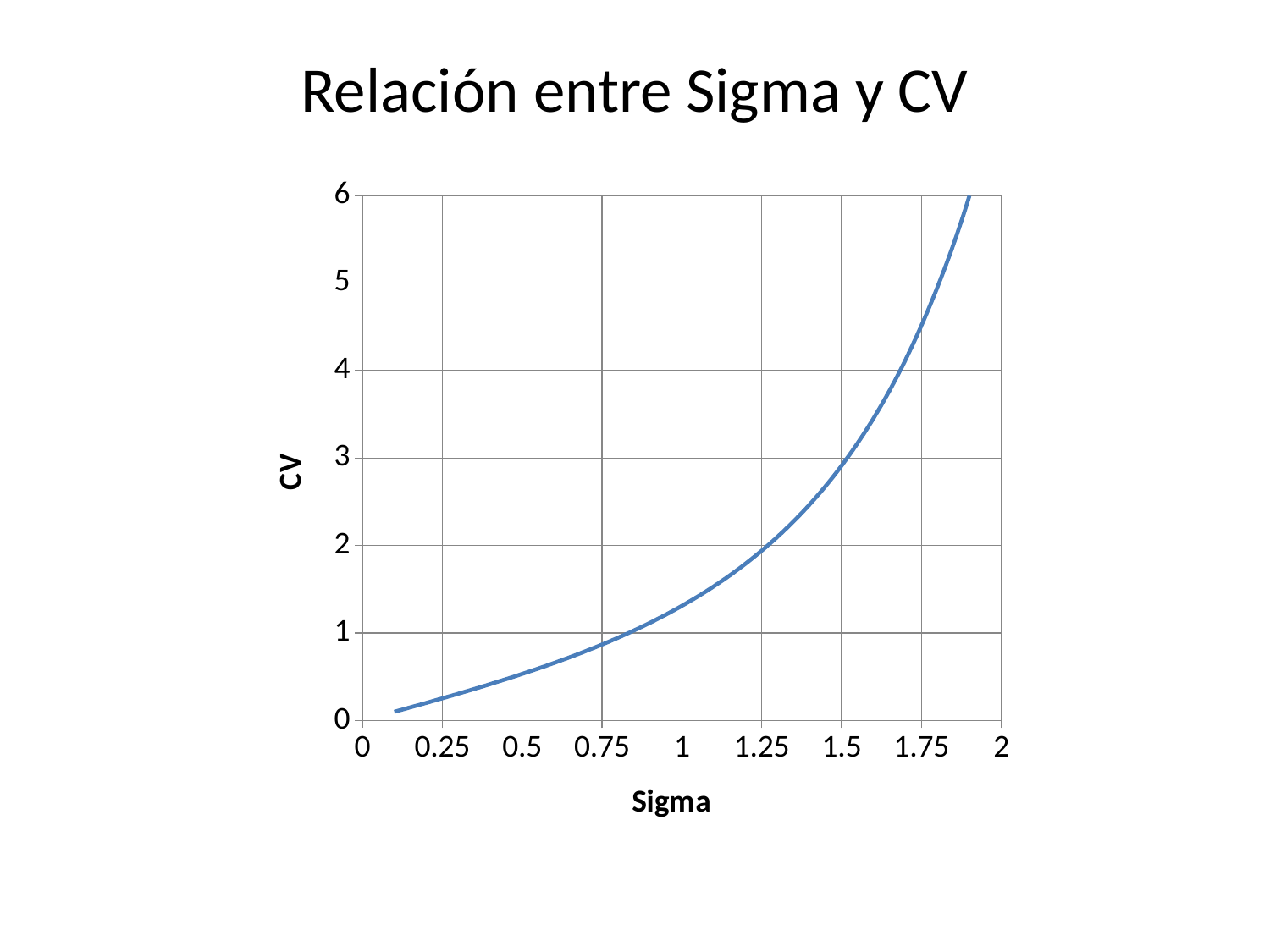
Is the value of CV at Sigma = 0.5 greater or less than 1? less What kind of chart is shown on the slide? line chart Is the value of CV at Sigma = 1 greater or less than 2? less Is the value of CV at Sigma = 1.75 greater or less than 4? greater Which has the larger CV value: Sigma = 0.5 or Sigma = 1.5? Sigma = 1.5 What is the title of the chart? Relación entre Sigma y CV What is the label of the horizontal axis? Sigma Does CV rise or fall as Sigma increases along the x axis? rise